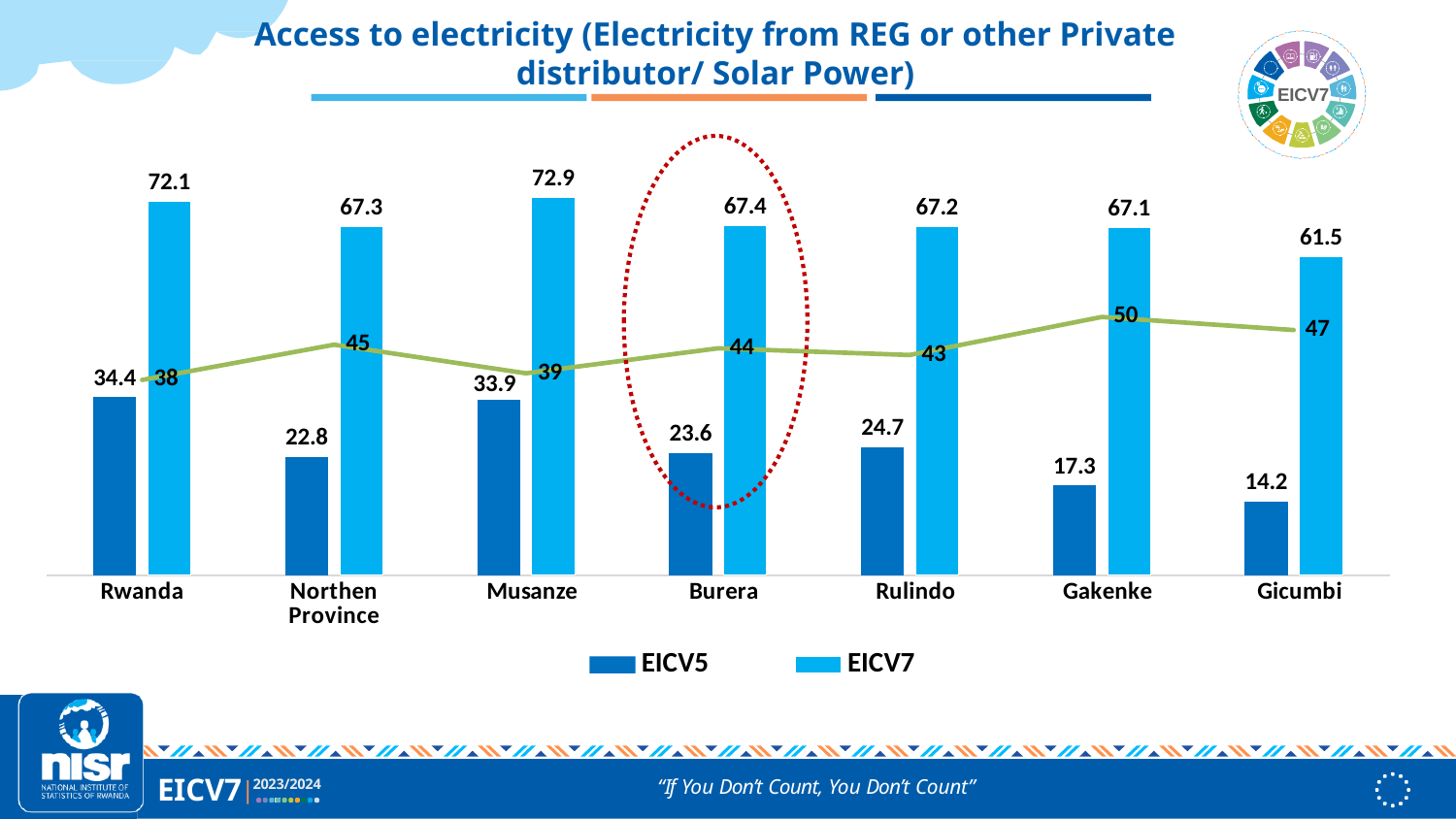
Which category is highlighted with a red dotted circle? Burera Which category has the lowest EICV5 value? Gicumbi How many series does the legend list? 2 Which is larger, the EICV5 value for Rwanda or the EICV5 value for Musanze? Rwanda What kind of chart is this? combination bar and line chart How many categories are shown on the x axis? 7 Which category has the highest EICV7 value? Musanze What is the difference between the EICV7 and EICV5 values for Rwanda? 37.7 What is the EICV7 value for Musanze? 72.9 What is the EICV7 value for Gicumbi? 61.5 What is the difference between the EICV5 values for Rulindo and Gakenke? 7.4 What is the EICV5 value for Burera? 23.6